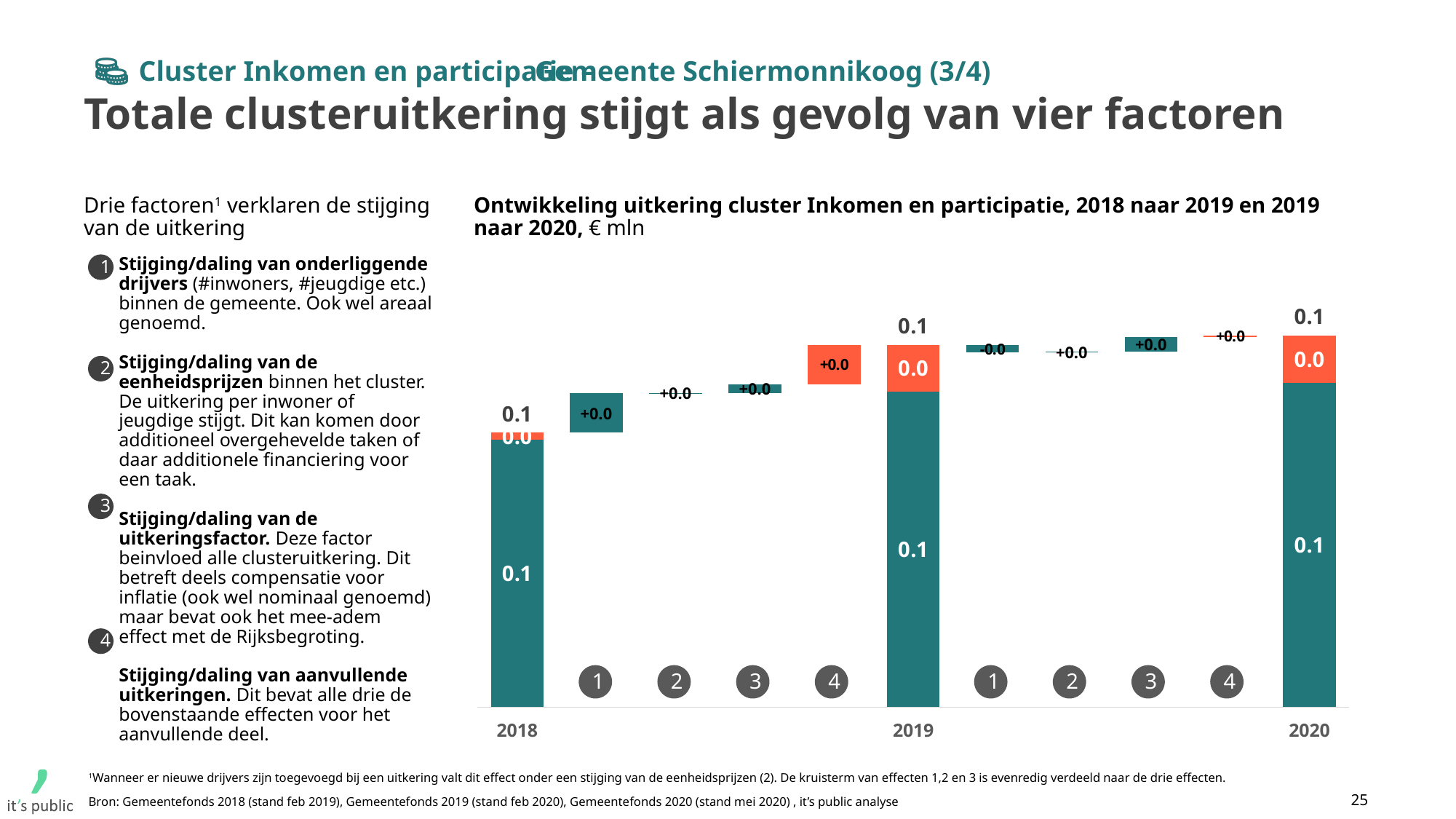
What is the total value shown above the 2020 bar? 0.1 How many numbered factor steps are shown between 2018 and 2019? 4 What kind of chart is shown on the slide? Bar chart (waterfall) What is the difference between the total for 2020 and the total for 2018? 0.0 How many years are shown as full bars on the x axis? 3 What is the value of the teal (lower) segment of the 2019 bar? 0.1 In what unit are the values in the chart expressed, according to the chart title? € mln What is the title of the chart? Ontwikkeling uitkering cluster Inkomen en participatie, 2018 naar 2019 en 2019 naar 2020, € mln What is the total value shown above the 2018 bar? 0.1 What is the data label on factor step 4 between 2018 and 2019? +0.0 What is the data label on factor step 1 between 2019 and 2020? -0.0 What is the value of the orange (upper) segment of the 2020 bar? 0.0